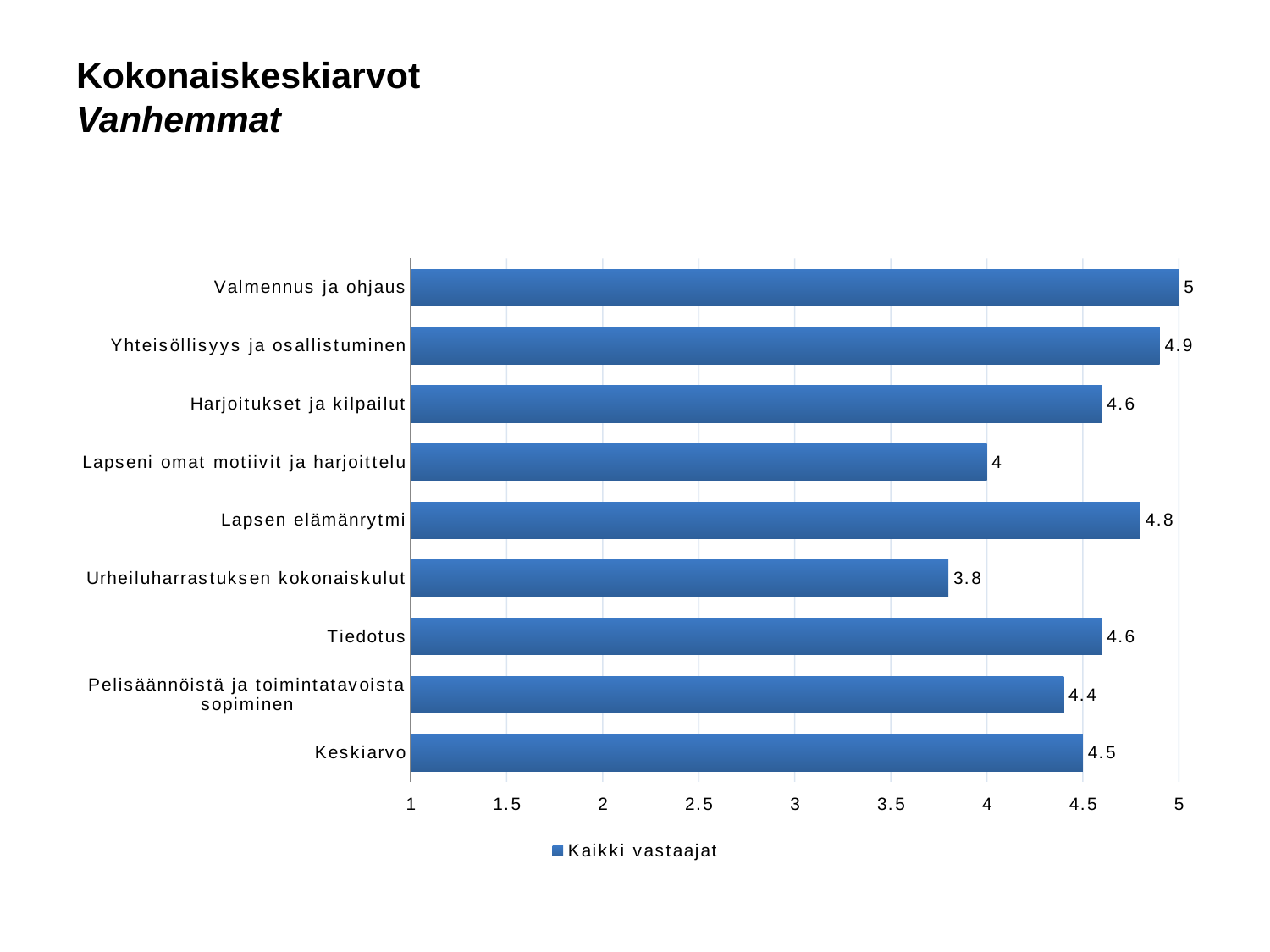
Is the value for Lapseni omat motiivit ja harjoittelu greater or less than 4.5? less Which is larger, the value for Yhteisöllisyys ja osallistuminen or the value for Pelisäännöistä ja toimintatavoista sopiminen? Yhteisöllisyys ja osallistuminen How many categories are shown on the chart? 9 What kind of chart is shown on the slide? bar chart What is the value for Urheiluharrastuksen kokonaiskulut? 3.8 Which category has the highest value? Valmennus ja ohjaus Which category has the lowest value? Urheiluharrastuksen kokonaiskulut What is the value for Lapsen elämänrytmi? 4.8 What is the value for Keskiarvo? 4.5 What is the difference between the values for Valmennus ja ohjaus and Urheiluharrastuksen kokonaiskulut? 1.2 What is the value for Valmennus ja ohjaus? 5 What series name does the legend show? Kaikki vastaajat